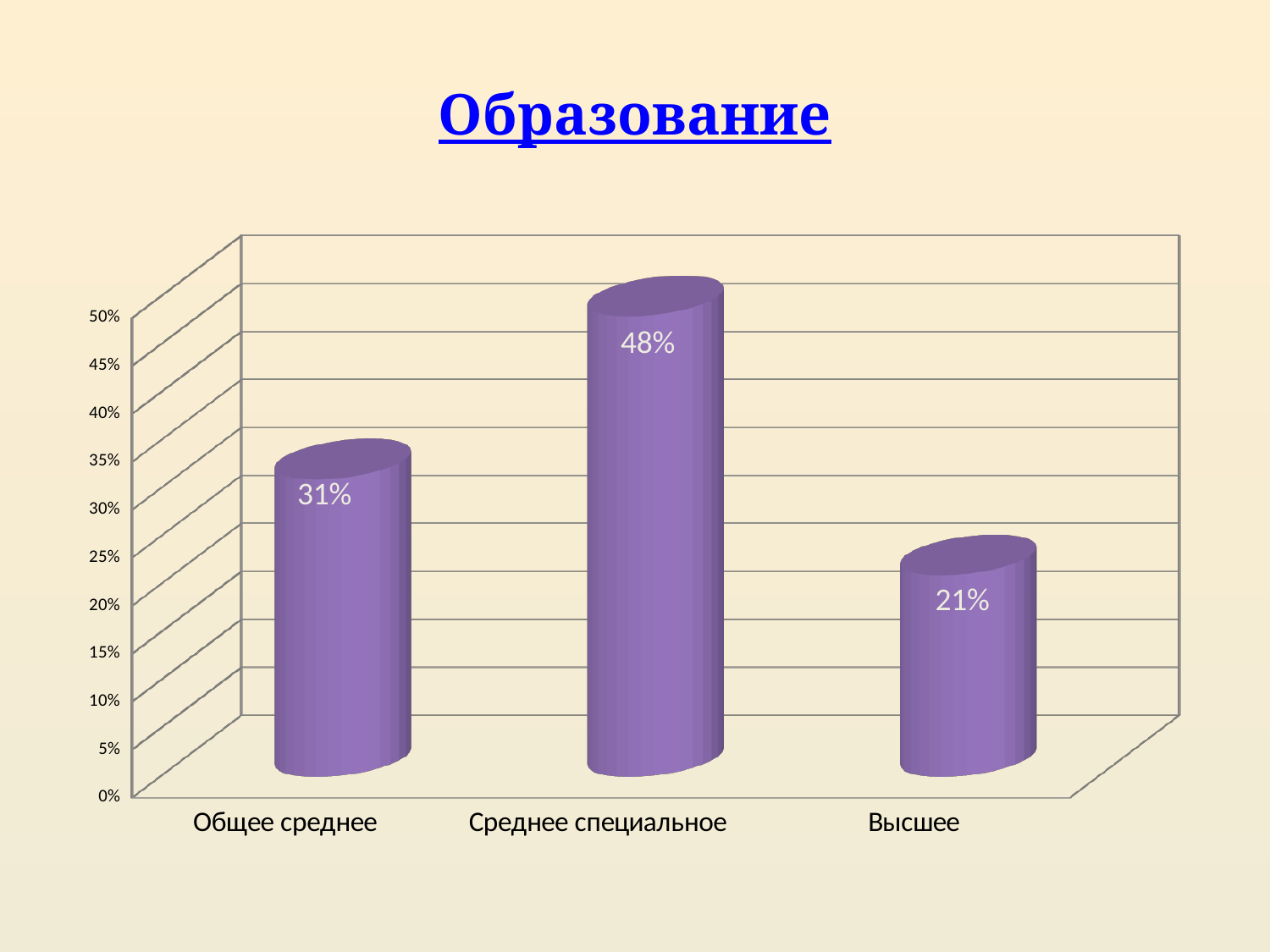
Which is larger, the value for Общее среднее or the value for Высшее? Общее среднее Is the value for Среднее специальное greater or less than 40%? greater What is the difference between the values for Среднее специальное and Общее среднее? 17% How many categories are shown on the chart? 3 What is the title of the slide? Образование Which category has the lowest value? Высшее What is the value for Среднее специальное? 48% What kind of chart is shown on the slide? bar chart What is the difference between the values for Общее среднее and Высшее? 10% What is the value for Общее среднее? 31% What is the value for Высшее? 21% Which category has the highest value? Среднее специальное